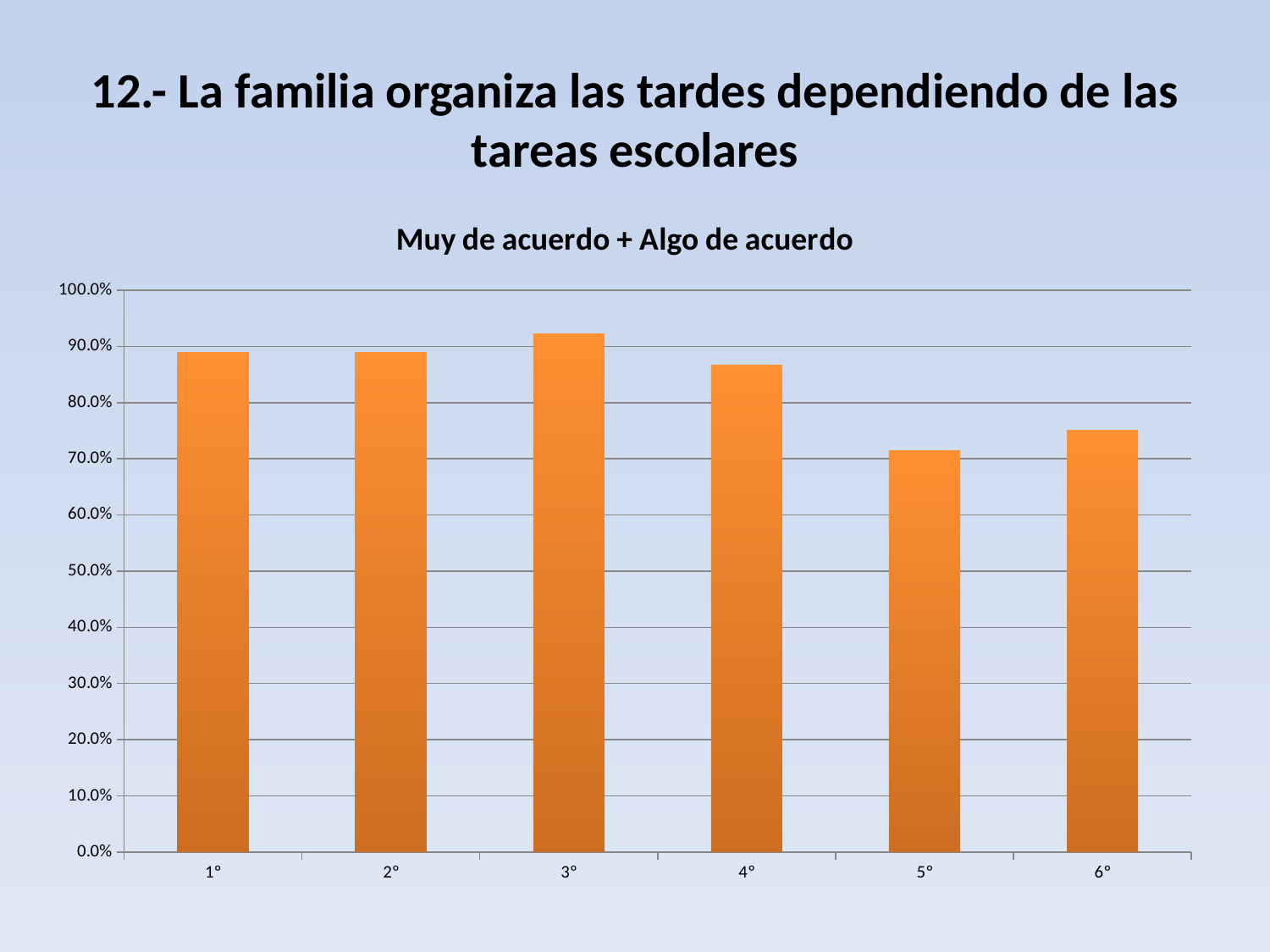
Is the value for 1° greater or less than 80.0%? greater Is the value for 4° greater or less than 90.0%? less Which is larger, the value for 6° or the value for 3°? 3° What is the title of the chart? Muy de acuerdo + Algo de acuerdo Which is larger, the value for 4° or the value for 5°? 4° How many categories are shown on the x axis of the chart? 6 Which category has the lowest bar in the chart? 5° Which category has the highest bar in the chart? 3° Is the value for 5° greater or less than 80.0%? less What kind of chart is shown on the slide? bar chart